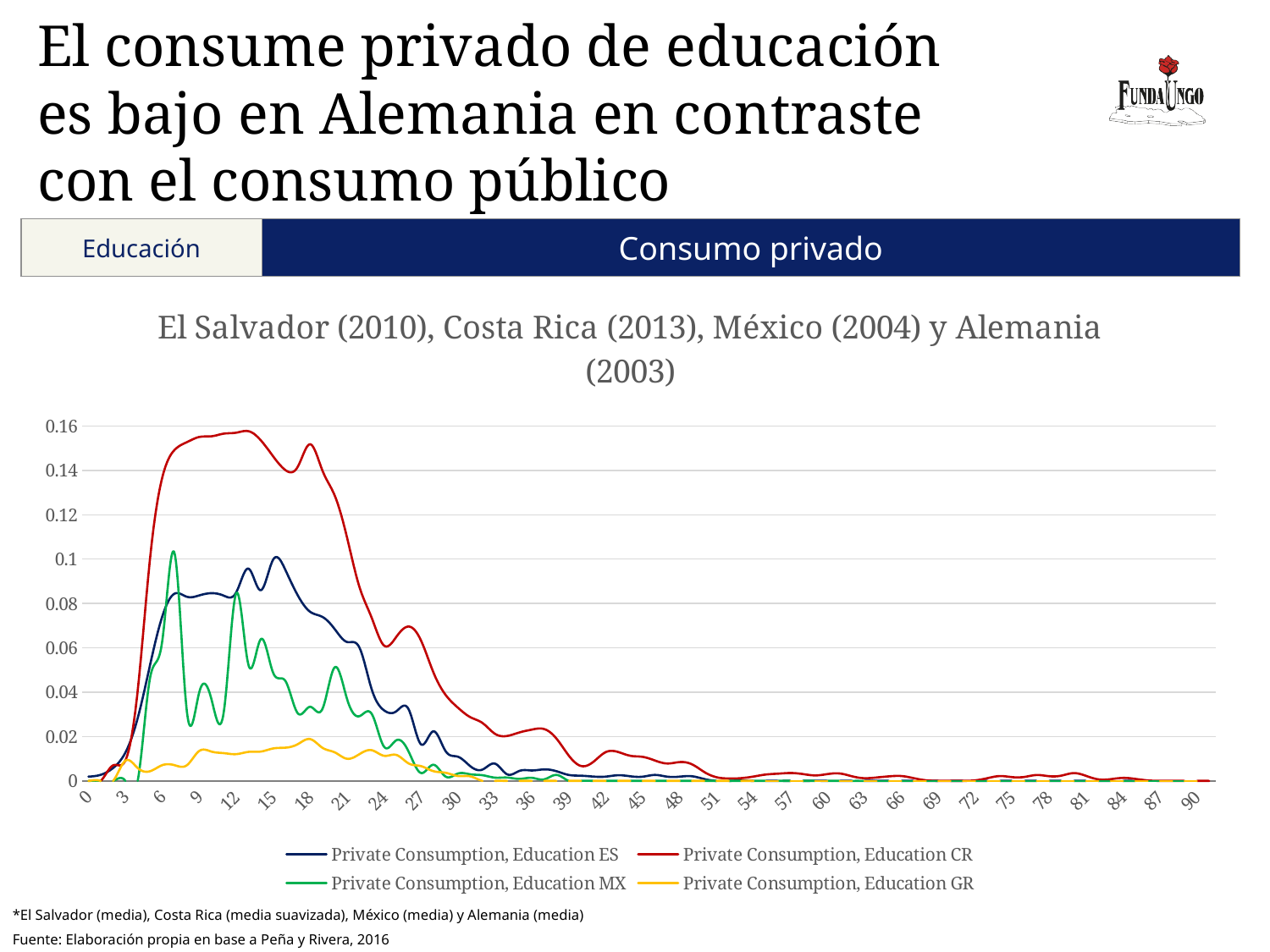
Is the value for Private Consumption, Education ES at age 15 greater or less than 0.08? greater Which series reaches the highest peak value on the chart? Private Consumption, Education CR Is the value for Private Consumption, Education CR at age 9 greater or less than 0.14? greater Is the value for Private Consumption, Education GR at age 18 greater or less than 0.04? less What kind of chart is shown on the slide? line chart At age 9, which is larger: Private Consumption, Education CR or Private Consumption, Education ES? Private Consumption, Education CR Which series is drawn in red in the legend? Private Consumption, Education CR Which series stays lowest across the whole age range? Private Consumption, Education GR What is the title of the chart? El Salvador (2010), Costa Rica (2013), México (2004) y Alemania (2003) How many series does the legend list? 4 Does the Private Consumption, Education CR series rise or fall between age 15 and age 51? fall